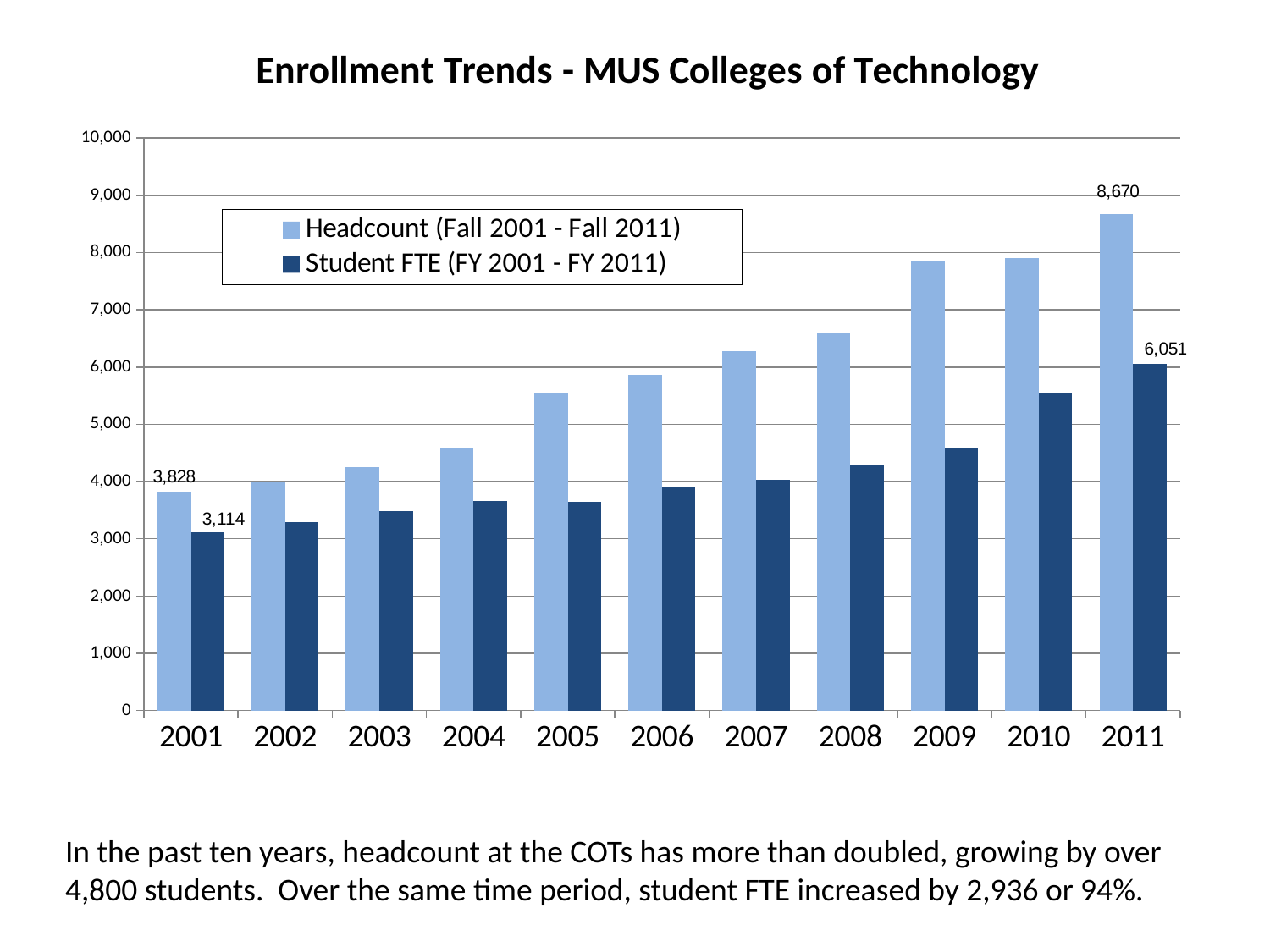
How many series does the legend list? 2 Is the Headcount value for 2009 greater or less than 7,000? greater How many years are shown on the x axis? 11 In which year is Student FTE lowest? 2001 In which year is Headcount highest? 2011 What is the Headcount value for 2001? 3,828 By how much did Headcount increase from 2001 to 2011? 4,842 What is the difference between Headcount and Student FTE in 2011? 2,619 What is the Student FTE value for 2011? 6,051 What is the Student FTE value for 2001? 3,114 Is the Student FTE value for 2005 greater or less than 4,000? less What is the Headcount value for 2011? 8,670